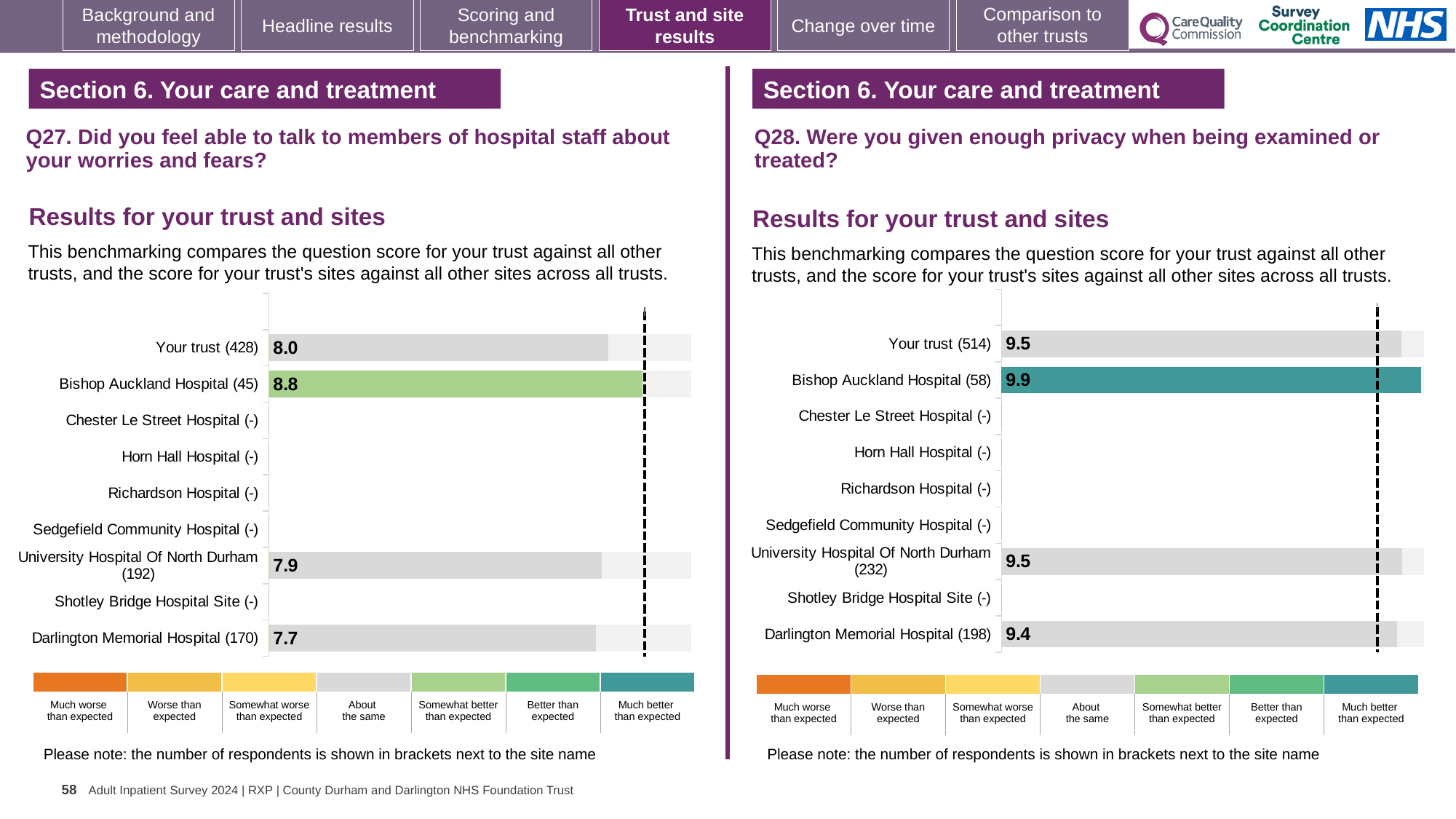
What kind of chart is used on the Q27 chart (left)? Bar chart On the Q28 chart (right), what is the score for University Hospital Of North Durham (232)? 9.5 On the Q27 chart (left), how many rows (sites and trust) are listed on the vertical axis? 9 On the Q27 chart (left), which site or trust row has the highest score? Bishop Auckland Hospital (45) On the Q28 chart (right), which is larger: the score for Your trust (514) or the score for Darlington Memorial Hospital (198)? Your trust (514) On the Q27 chart (left), what is the difference between the scores for Bishop Auckland Hospital (45) and Darlington Memorial Hospital (170)? 1.1 On the Q28 chart (right), which site or trust row has the highest score? Bishop Auckland Hospital (58) On the Q27 chart (left), which site or trust row has the lowest score? Darlington Memorial Hospital (170) On the Q28 chart (right), what is the difference between the scores for Bishop Auckland Hospital (58) and Your trust (514)? 0.4 On the Q27 chart (left), what is the score for Your trust (428)? 8.0 On the Q28 chart (right), what is the score for Darlington Memorial Hospital (198)? 9.4 On the Q27 chart (left), what is the score for Bishop Auckland Hospital (45)? 8.8